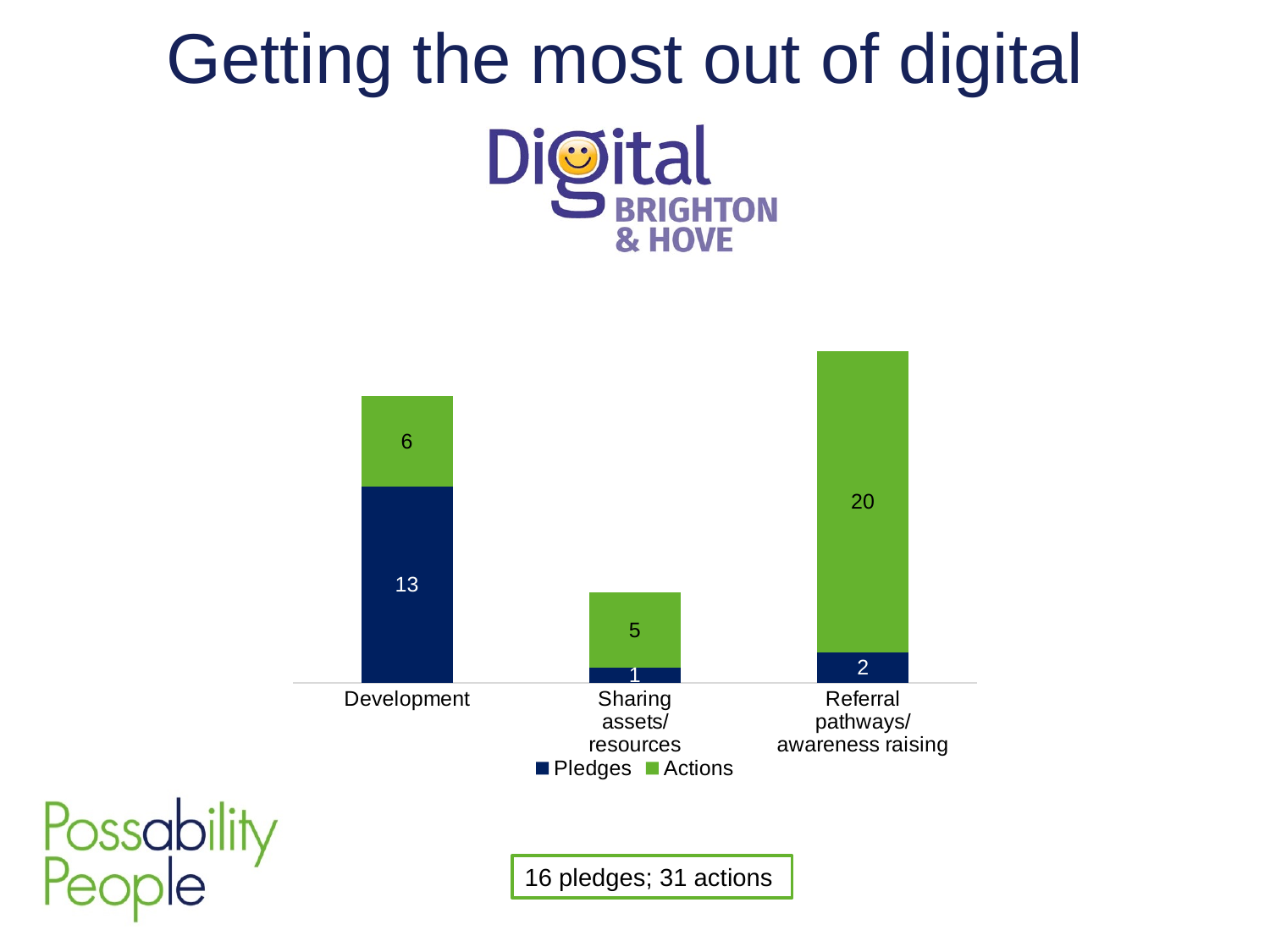
What is the Pledges value for Development? 13 How many categories are shown on the x axis? 3 What is the total of the stacked bar for Development? 19 Which category has the highest Pledges value? Development What is the difference between the Actions values for Referral pathways/awareness raising and Development? 14 Which is larger: the Pledges value for Development or the Pledges value for Referral pathways/awareness raising? Development What is the Actions value for Referral pathways/awareness raising? 20 What is the total of the stacked bar for Referral pathways/awareness raising? 22 Which category has the lowest Actions value? Sharing assets/resources What is the Pledges value for Sharing assets/resources? 1 How many series does the legend list? 2 What is the Actions value for Sharing assets/resources? 5